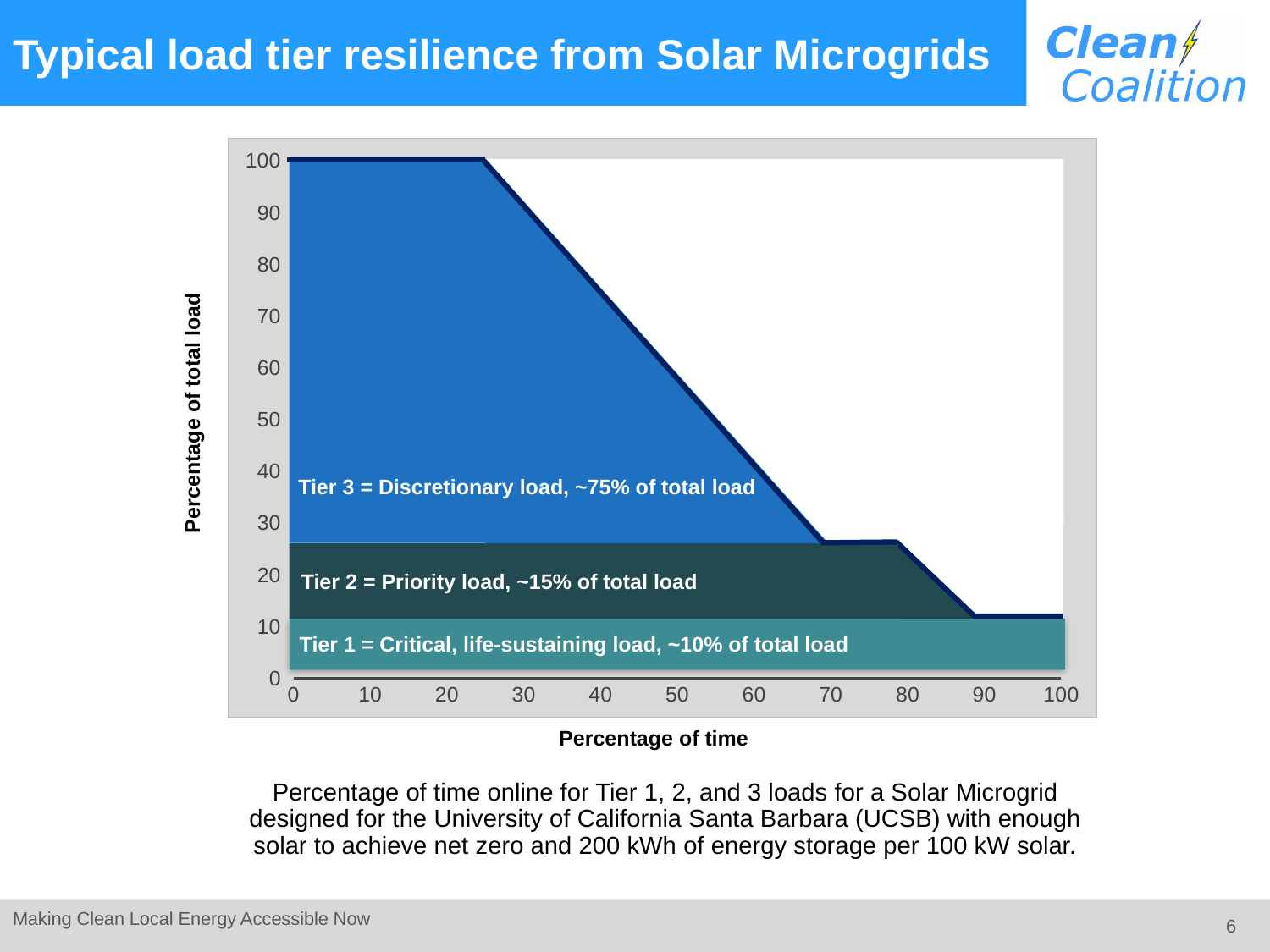
Is the percentage of total load at 60% of time greater or less than 50? less Is the percentage of total load at 80% of time greater or less than 20? greater What is the percentage of total load at 20% of time? 100 What is the percentage of total load at 0% of time? 100 What kind of chart is shown on the slide? area chart What is the label of the x axis? Percentage of time Do the plotted values rise or fall as the percentage of time increases? fall How many load tiers are labelled on the chart? 3 Which is larger, the percentage of total load at 30% of time or at 80% of time? 30% of time Is the percentage of total load at 50% of time greater or less than 40? greater Which tier is labelled as Critical, life-sustaining load? Tier 1